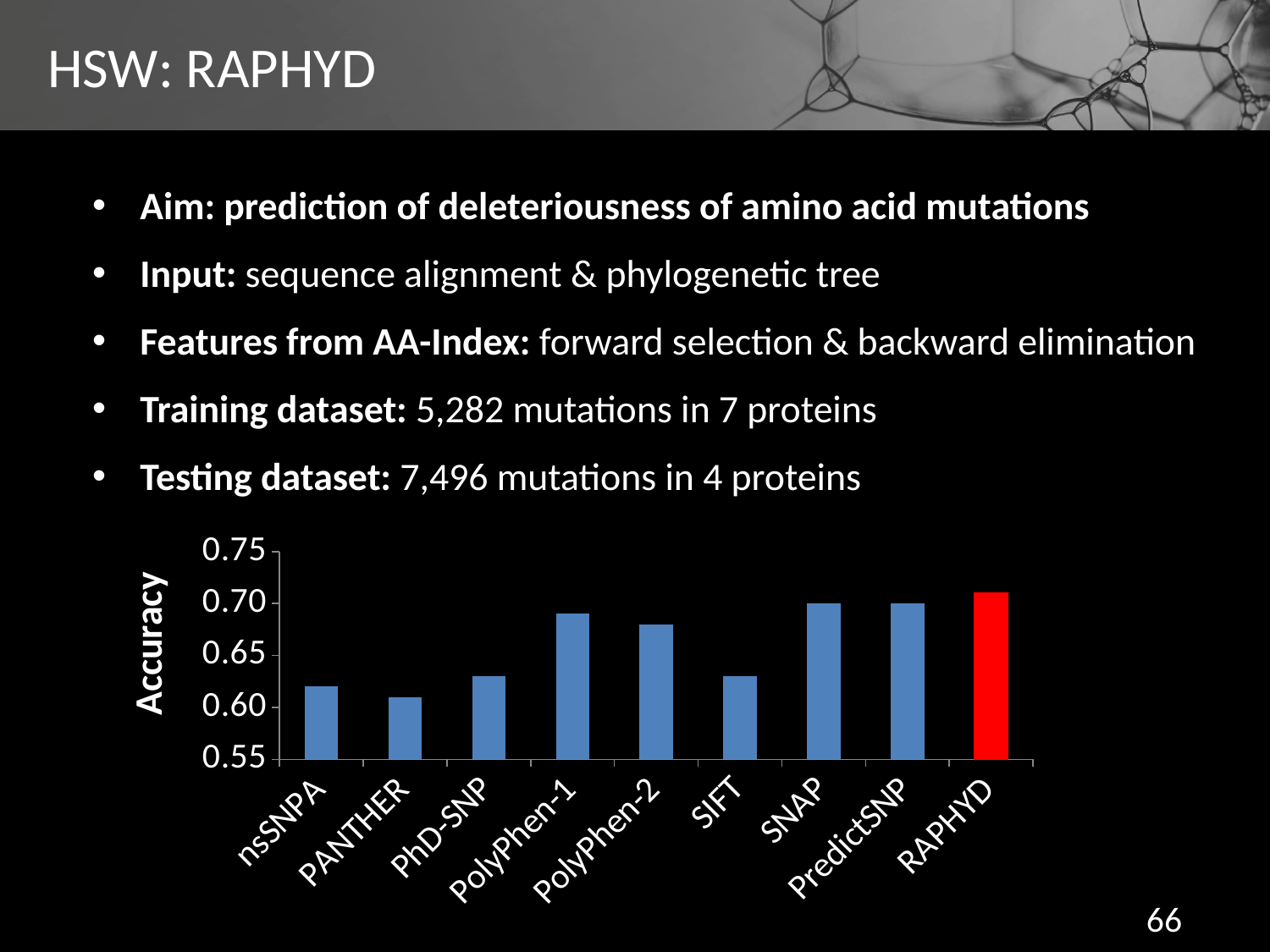
Is the accuracy for PolyPhen-1 greater or less than 0.65? greater Is the accuracy for nsSNPA greater or less than 0.65? less What kind of chart is shown on the slide? bar chart How many methods (categories) are plotted on the x axis of the chart? 9 Which has the higher accuracy, PolyPhen-1 or SIFT? PolyPhen-1 Is the accuracy for PolyPhen-2 greater or less than 0.65? greater Which bar in the chart is coloured red? RAPHYD What is the label of the vertical axis of the chart? Accuracy Which method has the lowest accuracy in the chart? PANTHER Which method has the highest accuracy in the chart? RAPHYD